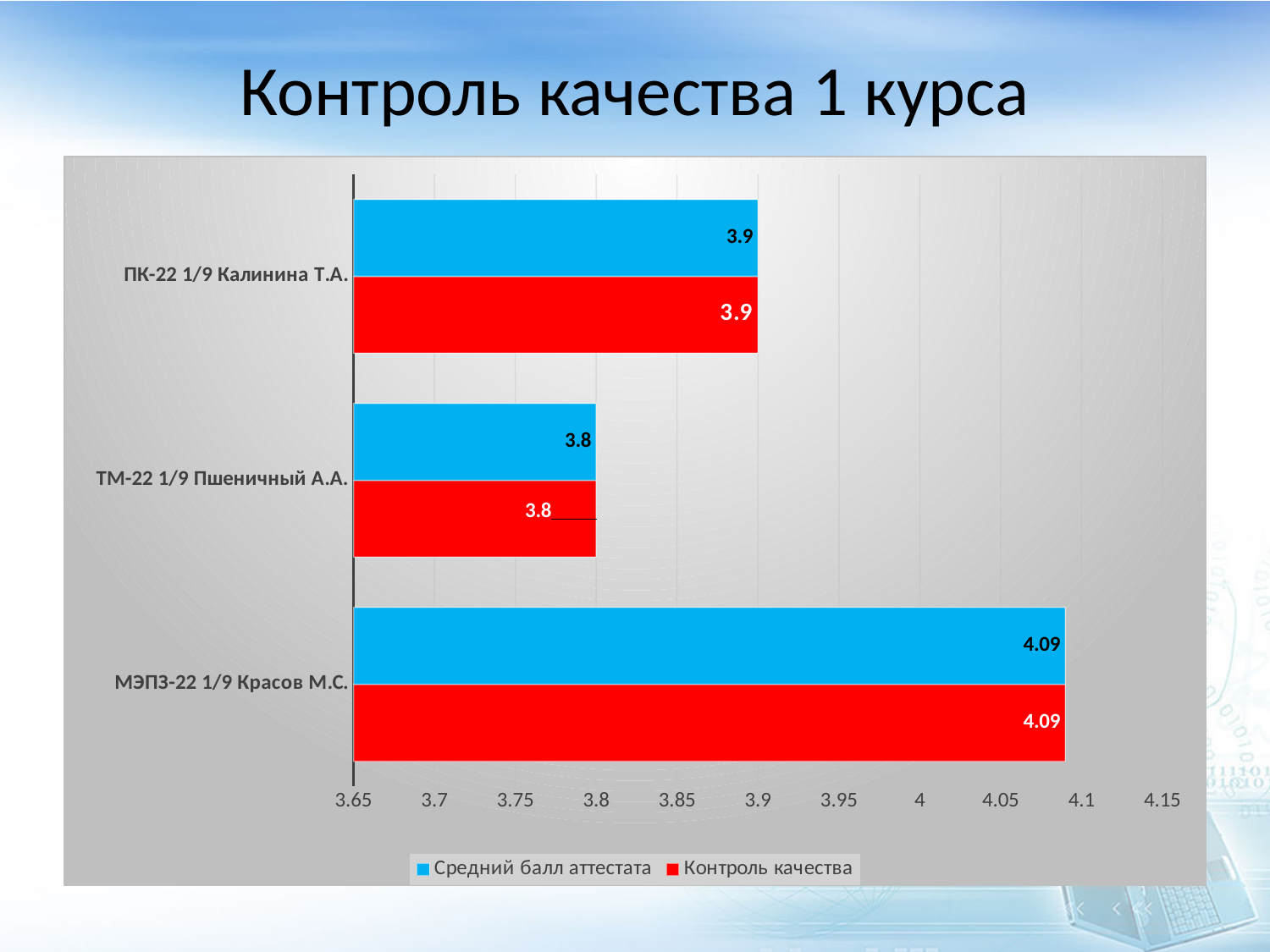
What is the difference between the Средний балл аттестата of МЭПЗ-22 1/9 Красов М.С. and ТМ-22 1/9 Пшеничный А.А.? 0.29 How many groups are shown on the chart? 3 Which is larger: the Контроль качества for ПК-22 1/9 Калинина Т.А. or for ТМ-22 1/9 Пшеничный А.А.? ПК-22 1/9 Калинина Т.А. What is the value of Контроль качества for ТМ-22 1/9 Пшеничный А.А.? 3.8 Which group has the highest Средний балл аттестата? МЭПЗ-22 1/9 Красов М.С. Is the Средний балл аттестата for МЭПЗ-22 1/9 Красов М.С. greater or less than 4? greater What is the value of Средний балл аттестата for ПК-22 1/9 Калинина Т.А.? 3.9 What is the value of Контроль качества for МЭПЗ-22 1/9 Красов М.С.? 4.09 What kind of chart is shown on the slide? bar chart How many series does the legend list? 2 Which group has the lowest Контроль качества? ТМ-22 1/9 Пшеничный А.А. What colour are the Контроль качества bars? red